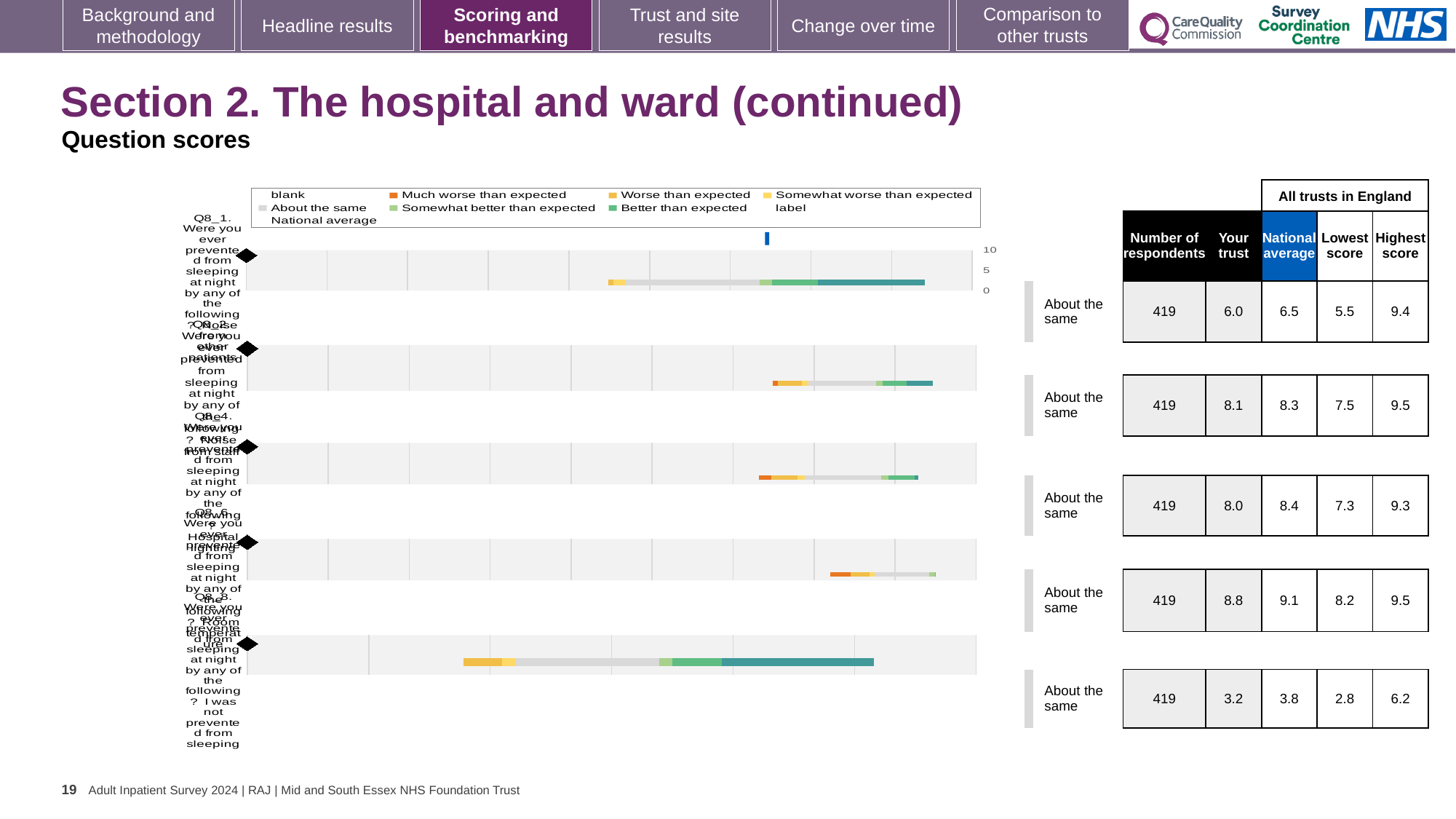
How many question rows (bars) are plotted in the chart? 5 What kind of chart is shown on the slide? bar chart In the table beside the chart, what is the 'National average' for the last row? 3.8 Which legend entry is shown in dark teal? Better than expected In the table beside the chart, what is the difference between the 'Highest score' and 'Lowest score' in the first row? 3.9 In the table beside the chart, what is the 'Your trust' score for the first row? 6.0 In the table beside the chart, which row has the lowest 'Your trust' score? the last row (3.2) In the table beside the chart, what is the number of respondents for each row? 419 In the table beside the chart, which row has the highest 'Your trust' score? the fourth row (8.8) How many entries does the chart legend list? 9 What benchmark rating is shown beside every question row in the chart? About the same Which legend entry is shown in orange? Much worse than expected